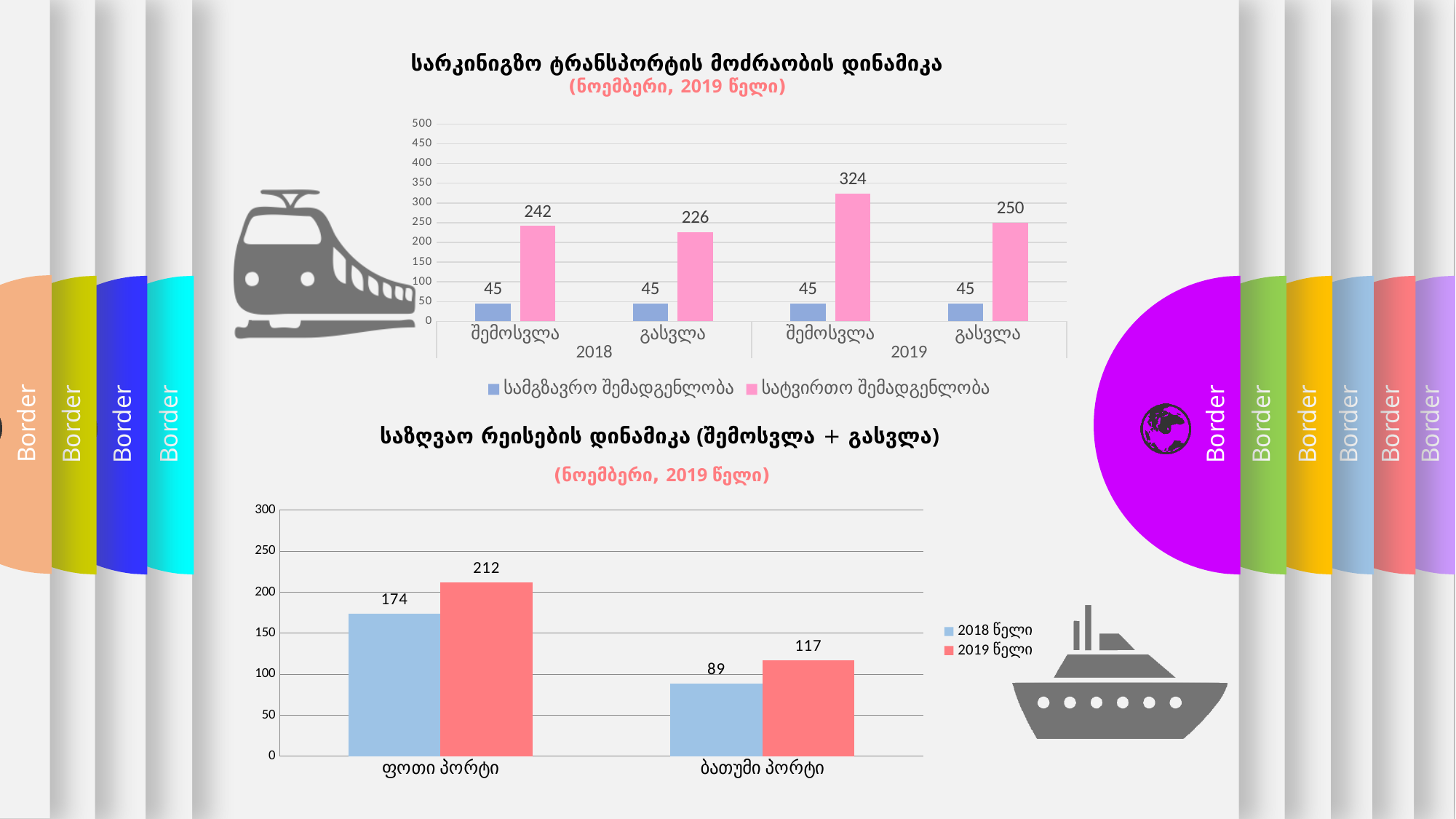
In the top chart, what is the value of სამგზავრო შემადგენლობა for შემოსვლა in 2018? 45 In the top chart, which category has the highest სატვირთო შემადგენლობა value? შემოსვლა 2019 In the bottom chart, what is the difference between the 2019 წელი and 2018 წელი values for ბათუმი პორტი? 28 In the bottom chart, which port has the larger 2018 წელი value, ფოთი პორტი or ბათუმი პორტი? ფოთი პორტი In the bottom chart (საზღვაო რეისების დინამიკა), what is the value for ფოთი პორტი in 2019 წელი? 212 In the top chart, how many series does the legend list? 2 In the top chart (სარკინიგზო ტრანსპორტის მოძრაობის დინამიკა), what is the value of სატვირთო შემადგენლობა for შემოსვლა in 2019? 324 What kind of chart is the bottom chart (საზღვაო რეისების დინამიკა)? bar chart In the top chart, what is the difference between the სატვირთო შემადგენლობა values for შემოსვლა 2019 and შემოსვლა 2018? 82 In the bottom chart, what is the value for ბათუმი პორტი in 2018 წელი? 89 In the top chart, is the სატვირთო შემადგენლობა value for გასვლა 2019 greater or less than 200? greater In the top chart, what is the value of სატვირთო შემადგენლობა for გასვლა in 2018? 226